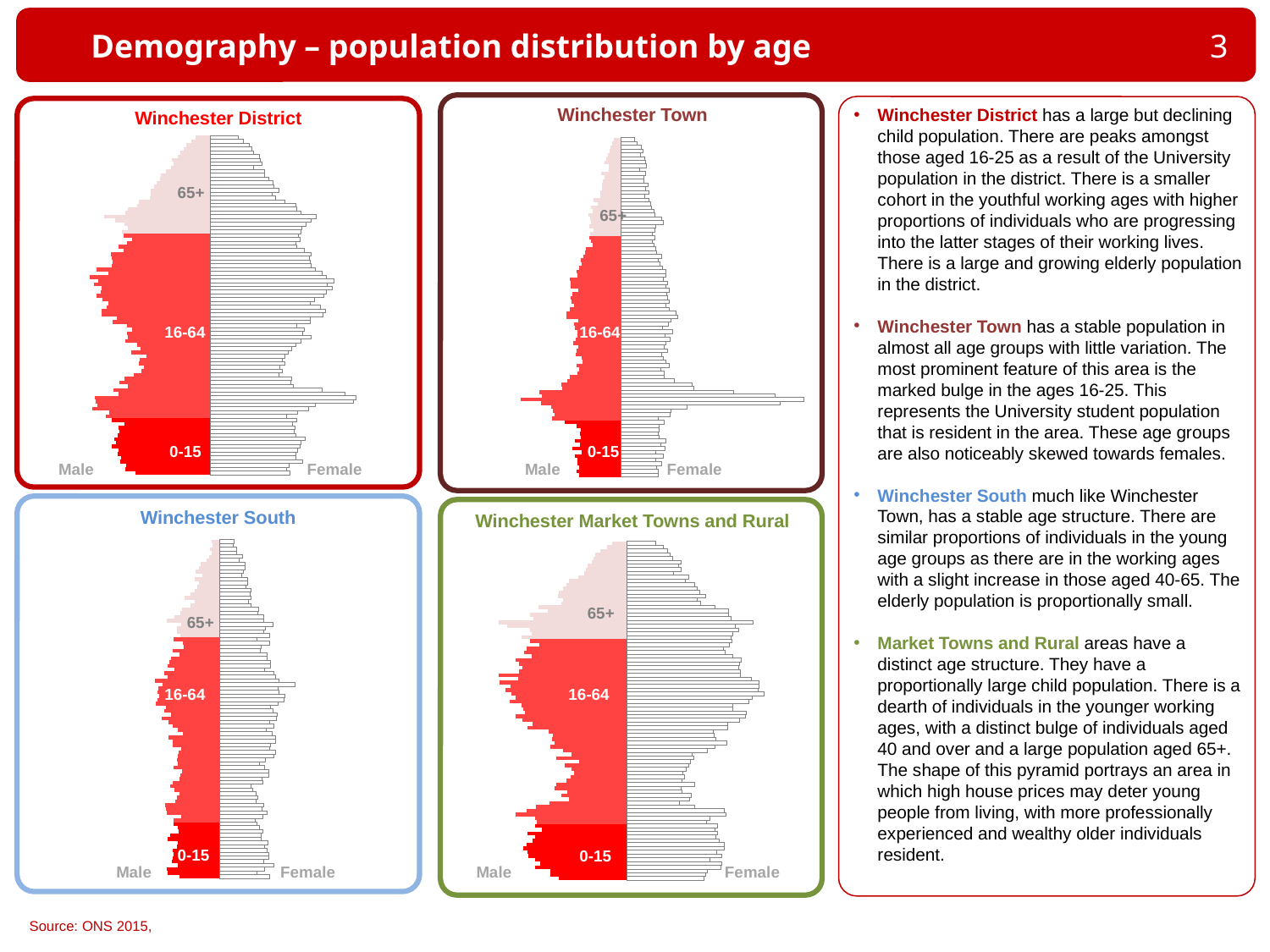
What kind of chart is the "Winchester District" chart? bar chart What is the title of the bottom-right chart? Winchester Market Towns and Rural On the "Winchester South" chart, which age group is shaded in the darkest red? 0-15 How many charts are shown on the slide? 4 On the "Winchester Town" chart, is the longest bar on the Male side or the Female side? Female How many population groups (sides) does each pyramid chart show? 2 How many age groups are labelled on the "Winchester District" chart? 3